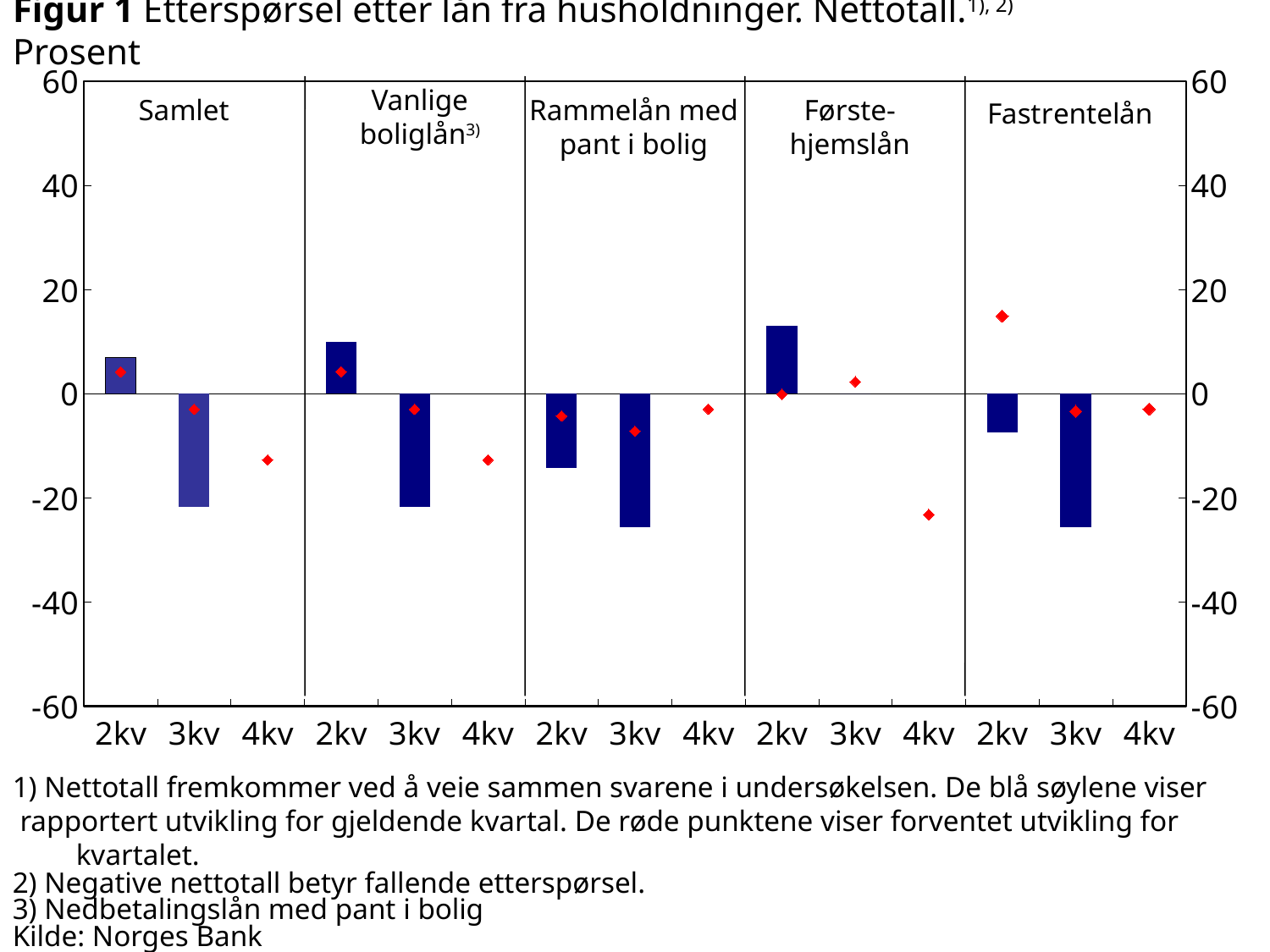
Is the 3kv bar for Rammelån med pant i bolig greater or less than -20? less In the Samlet panel, do the bars rise or fall from 2kv to 3kv? fall According to the footnote, what do the red points show? Forventet utvikling for kvartalet What kind of chart is shown in Figur 1? bar chart How many panels (loan categories) does the chart have? 5 Is the 2kv red point for Fastrentelån greater or less than 10? greater Is the 2kv bar for Førstehjemslån greater or less than 10? greater How many quarters are shown on the x axis within each panel? 3 Which panel has the highest 2kv bar? Førstehjemslån Which is larger, the 2kv bar for Samlet or the 2kv bar for Førstehjemslån? Førstehjemslån